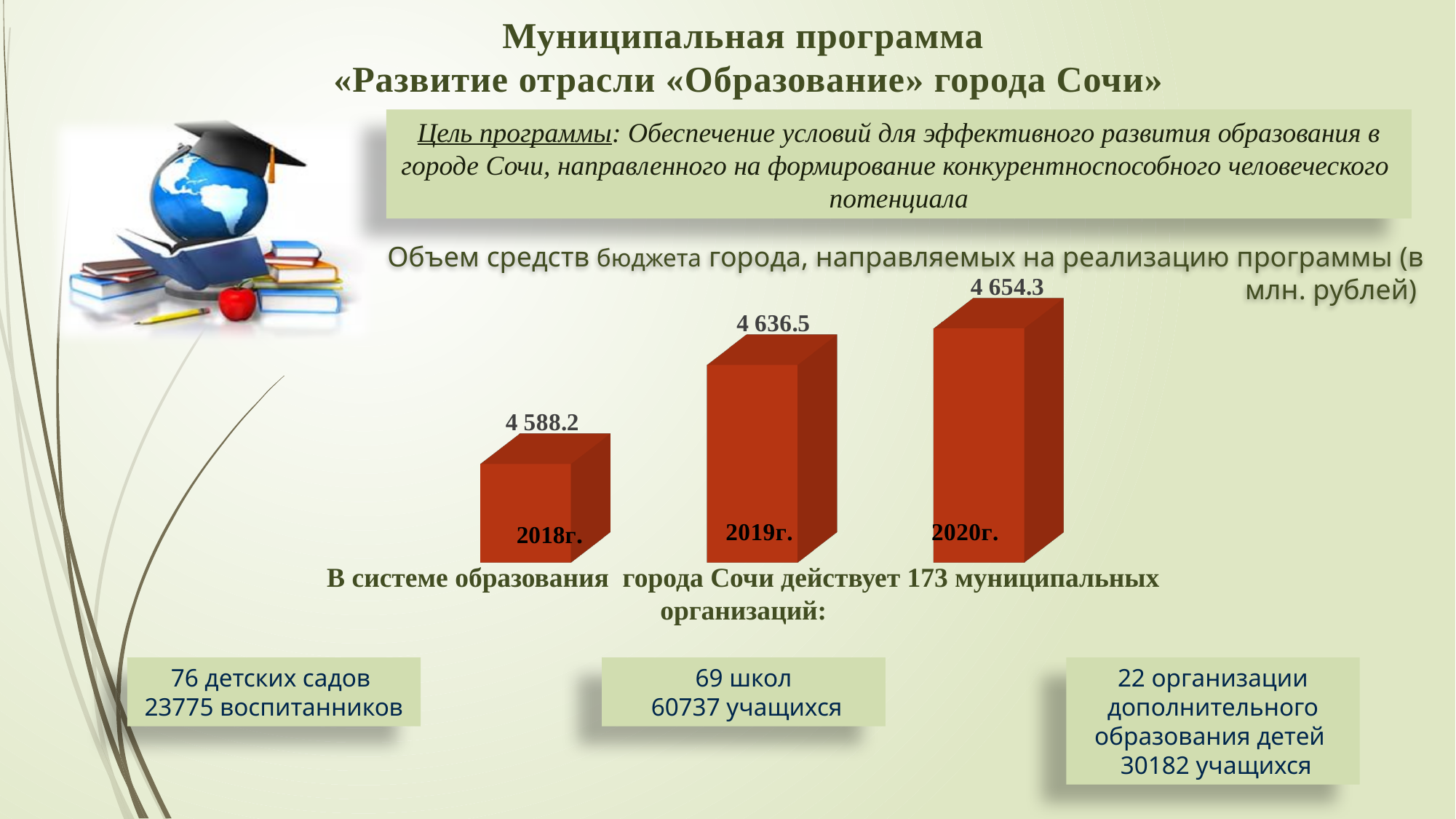
What is the difference between the values for 2020г. and 2018г.? 66.1 Which year has the highest value in the chart? 2020г. How many bars are shown in the chart? 3 In what units are the chart values expressed, according to the chart title? млн. рублей What is the value shown for 2020г. in the chart? 4 654.3 What is the value shown for 2019г. in the chart? 4 636.5 What is the difference between the values for 2019г. and 2018г.? 48.3 What is the value shown for 2018г. in the chart? 4 588.2 Which is larger, the value for 2019г. or the value for 2020г.? 2020г. Which year has the lowest value in the chart? 2018г. Do the values rise or fall from 2018г. to 2020г.? Rise What kind of chart is shown on the slide? Bar chart